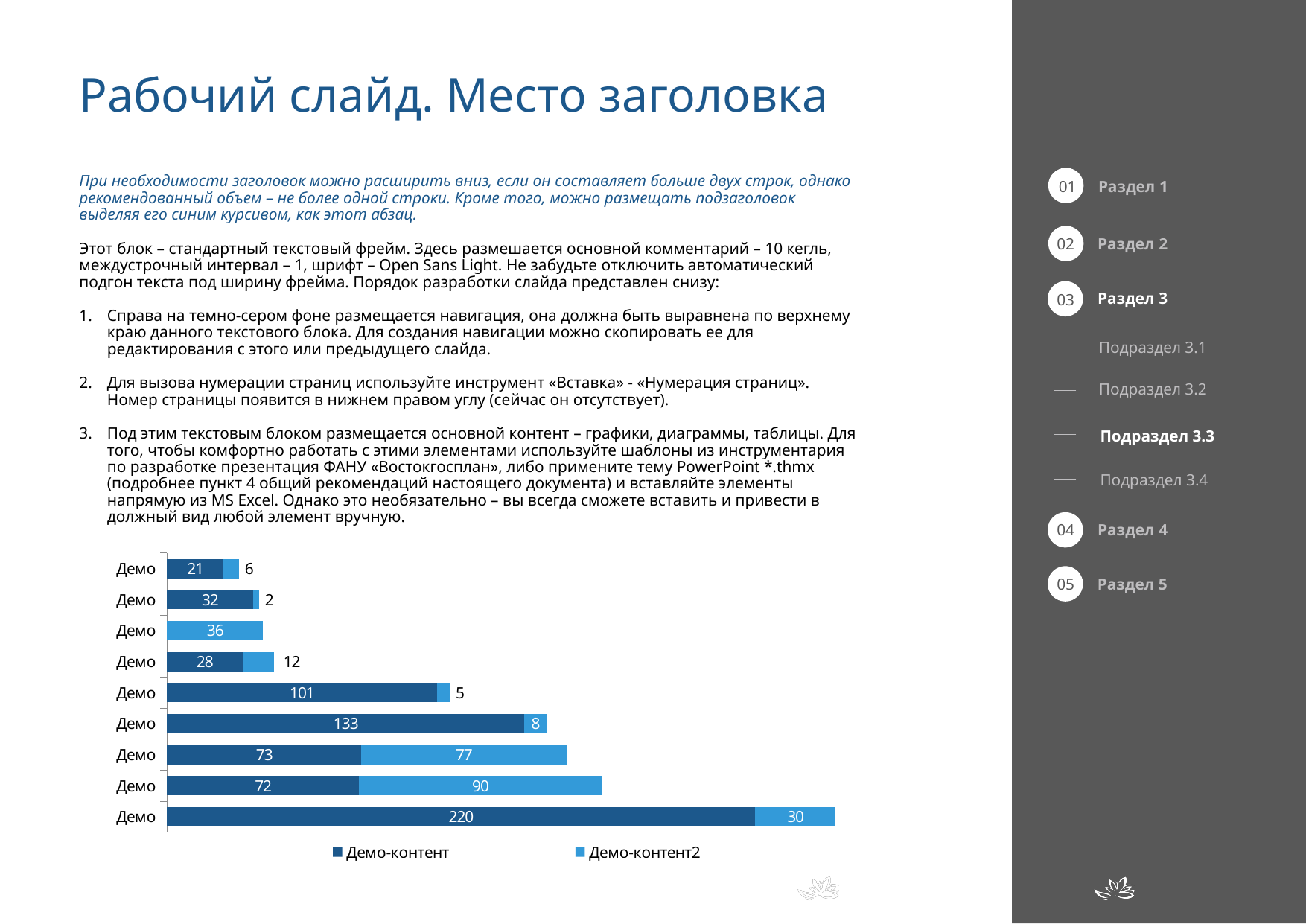
What is the difference between the largest Демо-контент value (220) and the second largest (133)? 87 What is the total of the stacked bar with segments 72 and 90? 162 What are the two series names shown in the chart legend? Демо-контент and Демо-контент2 How many series does the chart legend list? 2 In the bar with segments 72 and 90, which series has the larger value? Демо-контент2 Which bar has the highest Демо-контент value? The bottom bar (220) What kind of chart is shown on the slide? Stacked bar chart What is the Демо-контент value for the bottom bar of the chart? 220 What is the Демо-контент2 value for the bottom bar of the chart? 30 What is the total of the bottom stacked bar (220 and 30)? 250 How many bars (categories) are plotted in the chart? 9 What is the smallest Демо-контент2 value labelled on the chart? 2